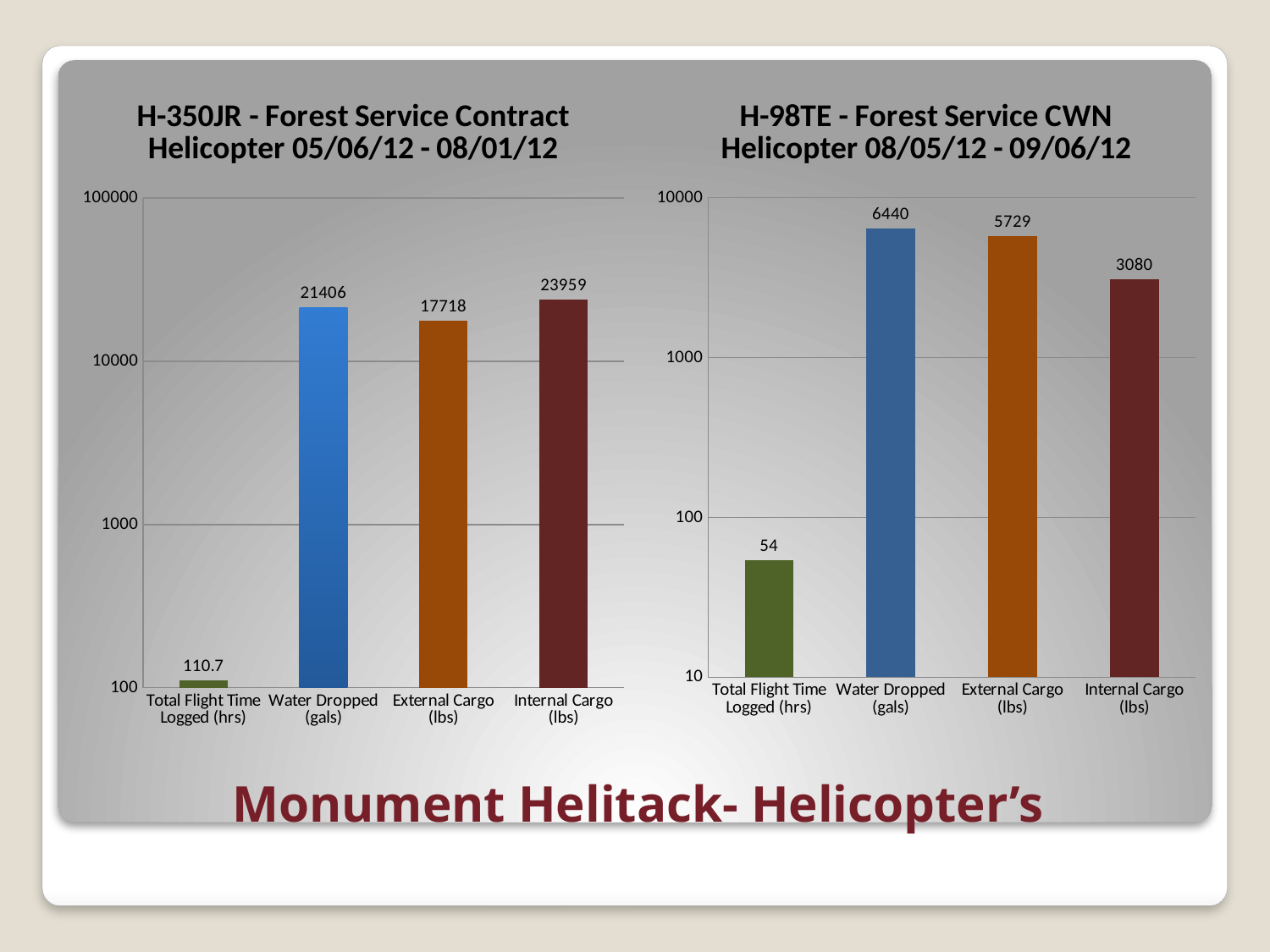
In the H-350JR chart, which is larger: Water Dropped (gals) or External Cargo (lbs)? Water Dropped (gals) In the H-98TE chart, what is the value for External Cargo (lbs)? 5729 In the H-98TE chart, what is the difference between Water Dropped (gals) and Internal Cargo (lbs)? 3360 In the H-350JR chart, what is the value for Water Dropped (gals)? 21406 In the H-350JR chart, what is the difference between Internal Cargo (lbs) and External Cargo (lbs)? 6241 In the H-350JR chart, what is the value for Total Flight Time Logged (hrs)? 110.7 In the H-98TE chart, which category has the highest value? Water Dropped (gals) In the H-98TE chart, which category has the lowest value? Total Flight Time Logged (hrs) In the H-98TE chart, what is the value for Total Flight Time Logged (hrs)? 54 What type of chart is the H-350JR chart? Bar chart In the H-350JR chart, which category has the highest value? Internal Cargo (lbs) How many categories are shown in the H-98TE chart? 4